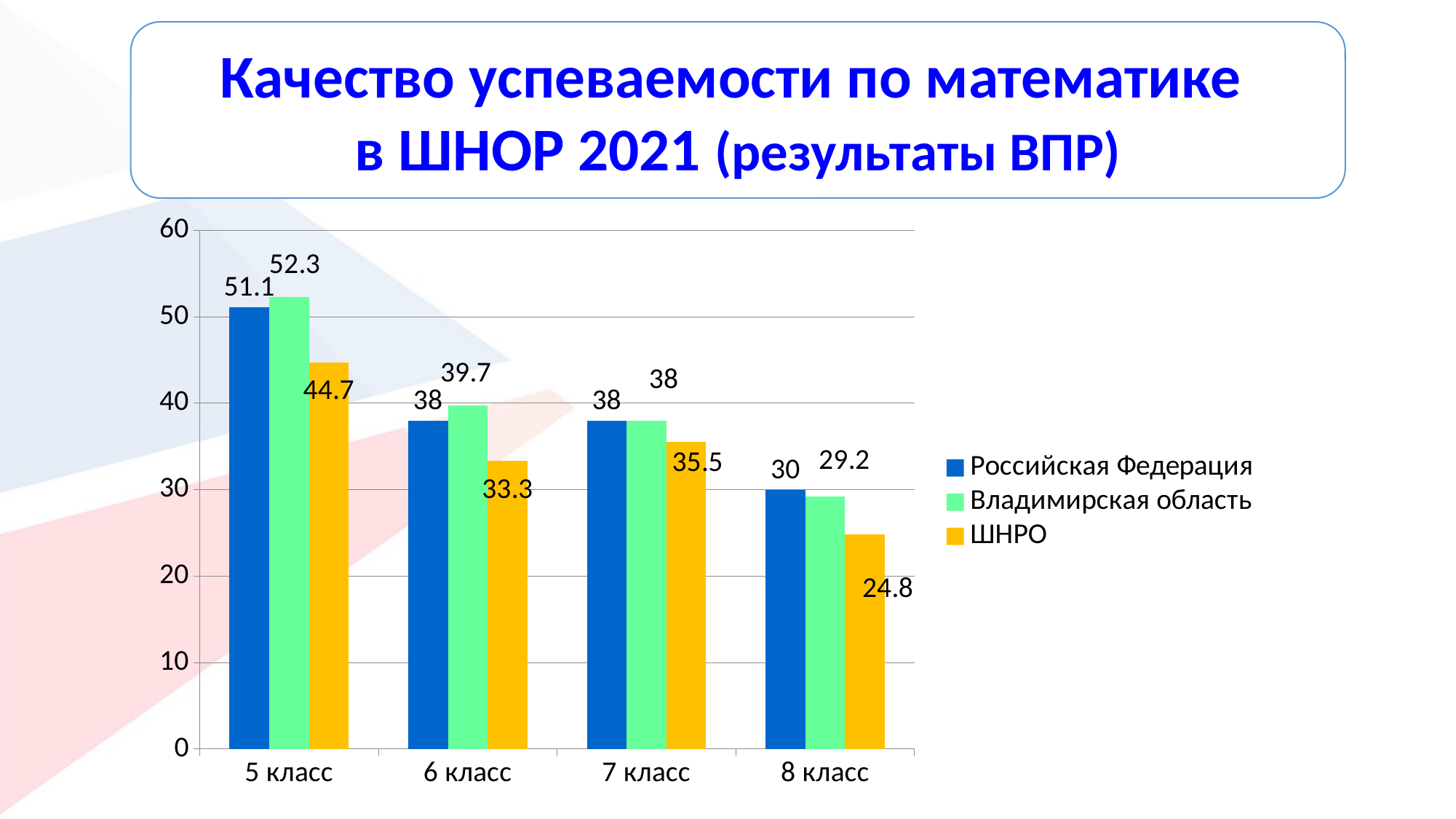
Is the value for ШНРО in 6 класс greater or less than 40? less Which is larger in 7 класс: the value for Российская Федерация or the value for ШНРО? Российская Федерация What is the value for Российская Федерация in 5 класс? 51.1 Do the values for ШНРО rise or fall from 5 класс to 8 класс? fall What is the difference between the Владимирская область and ШНРО values in 5 класс? 7.6 How many series does the legend list? 3 Which class has the lowest value for Владимирская область? 8 класс How many classes are shown on the x axis? 4 What is the value for Владимирская область in 6 класс? 39.7 What kind of chart is shown on the slide? bar chart What is the value for ШНРО in 8 класс? 24.8 Which class has the highest value for ШНРО? 5 класс